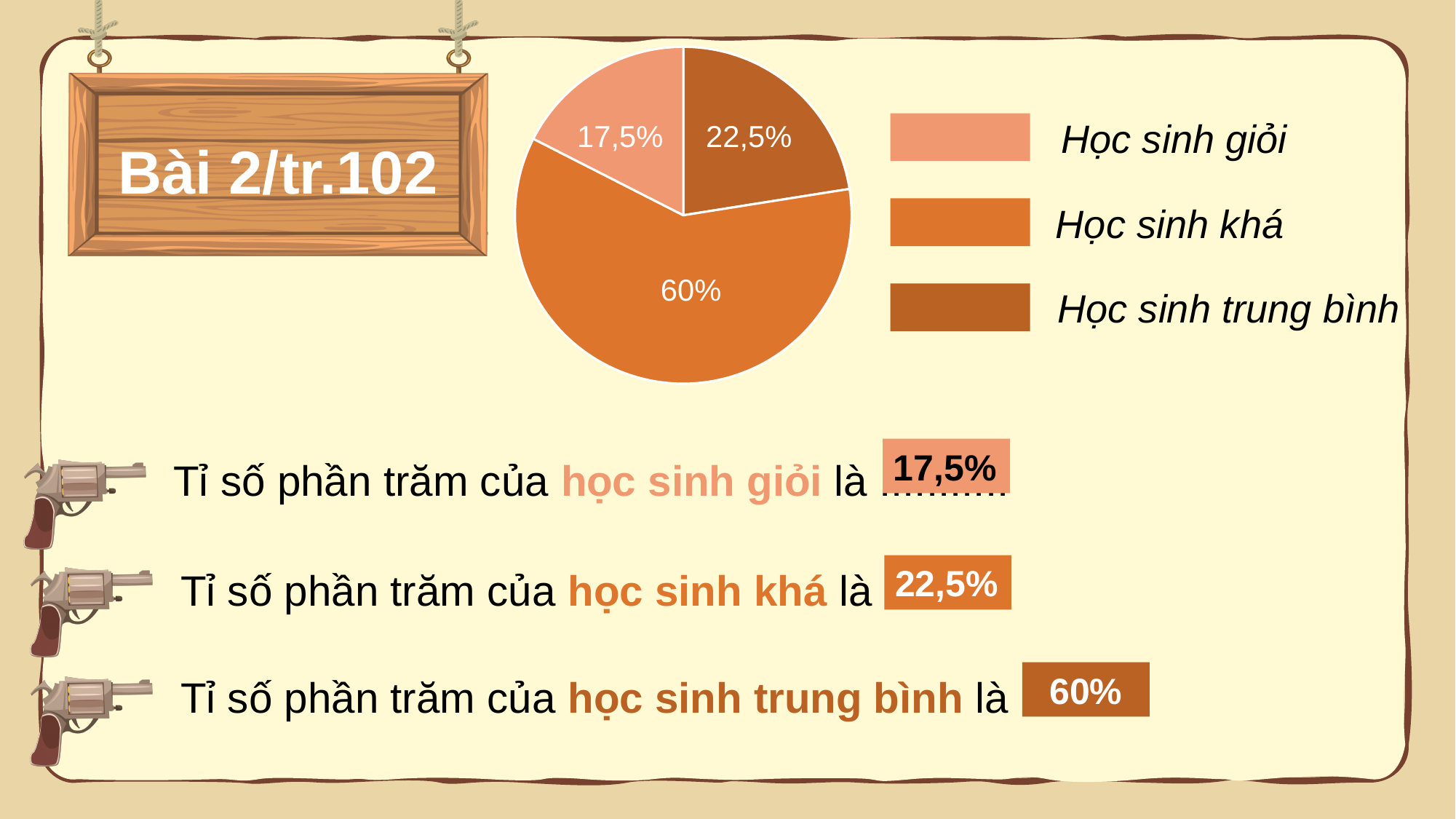
What is the difference between the largest slice (60%) and the smallest slice (17,5%) in the pie chart? 42,5% Which legend entry is shown with the lightest (pale salmon) colour? Học sinh giỏi Which is larger in the pie chart: the 22,5% slice or the 17,5% slice? 22,5% What share of the pie does the largest slice take? 60% Which legend entry is shown with the darkest brown colour? Học sinh trung bình What is the value of the largest slice in the pie chart? 60% How many slices does the pie chart have? 3 What kind of chart is shown on the slide? pie chart What percentage does the pie chart show for Học sinh giỏi? 17,5% What do the three slices of the pie chart add up to? 100% How many entries does the legend of the pie chart list? 3 What is the value of the smallest slice in the pie chart? 17,5%